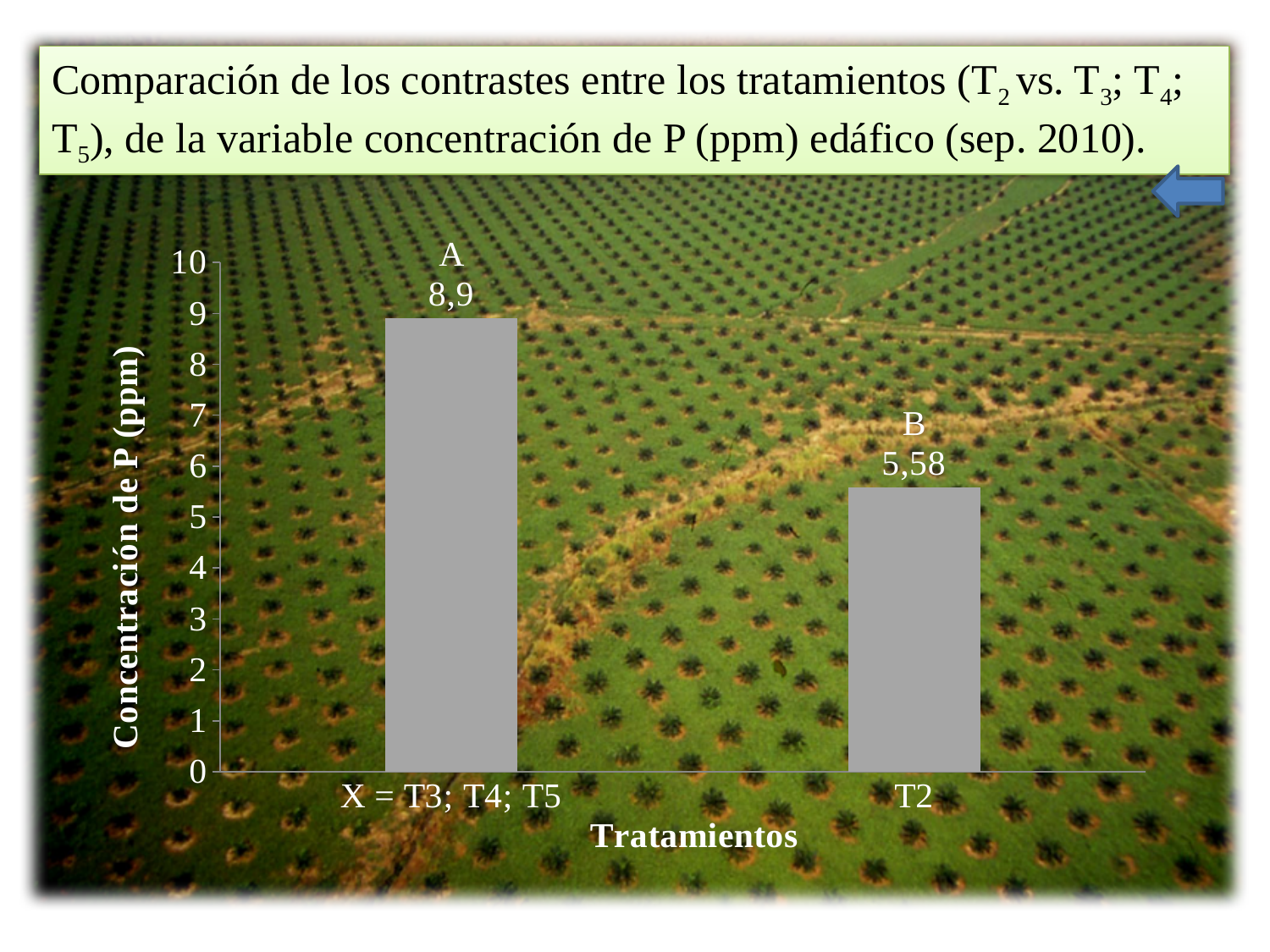
What is the difference between the values for X = T3; T4; T5 and T2? 3,32 What letter is printed above the bar for T2? B Is the value for T2 greater or less than 6? less What is the label of the y axis? Concentración de P (ppm) What is the value for X = T3; T4; T5? 8,9 Which category has the lowest concentration of P? T2 Which category has the highest concentration of P? X = T3; T4; T5 Which is larger, the value for T2 or the value for X = T3; T4; T5? X = T3; T4; T5 Is the value for X = T3; T4; T5 greater or less than 8? greater How many categories are shown on the x axis? 2 What kind of chart is shown on the slide? bar chart What is the value for T2? 5,58